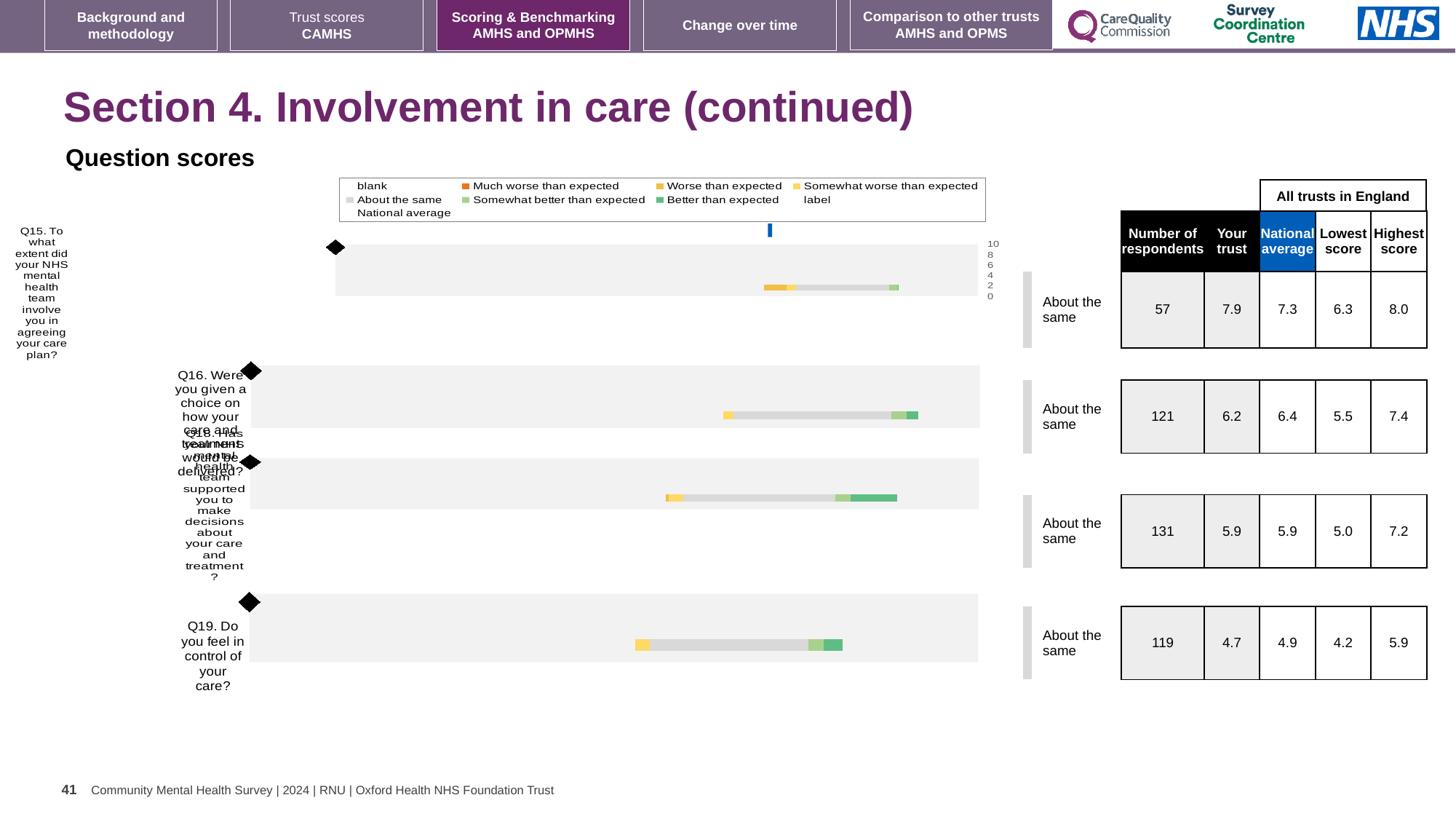
In the table beside the chart, what is the difference between the highest score and lowest score for Q16? 1.9 In the table beside the chart, what is the national average for Q19? 4.9 What kind of chart is used to show the question scores on this slide? bar chart In the table beside the chart, which question has the highest 'Your trust' score? Q15 How many survey questions are plotted as bars in the question scores chart? 4 What benchmark category is shown next to each question's bar in the chart? About the same In the table beside the chart, what is the 'Your trust' score for Q15? 7.9 In the table beside the chart, is the 'Your trust' score for Q16 larger or smaller than the national average for Q16? smaller What is the highest value shown on the chart's axis? 10 In the table beside the chart, which question has the lowest 'Your trust' score? Q19 In the chart legend, what colour represents 'Much worse than expected'? orange In the table beside the chart, how many respondents answered Q18? 131